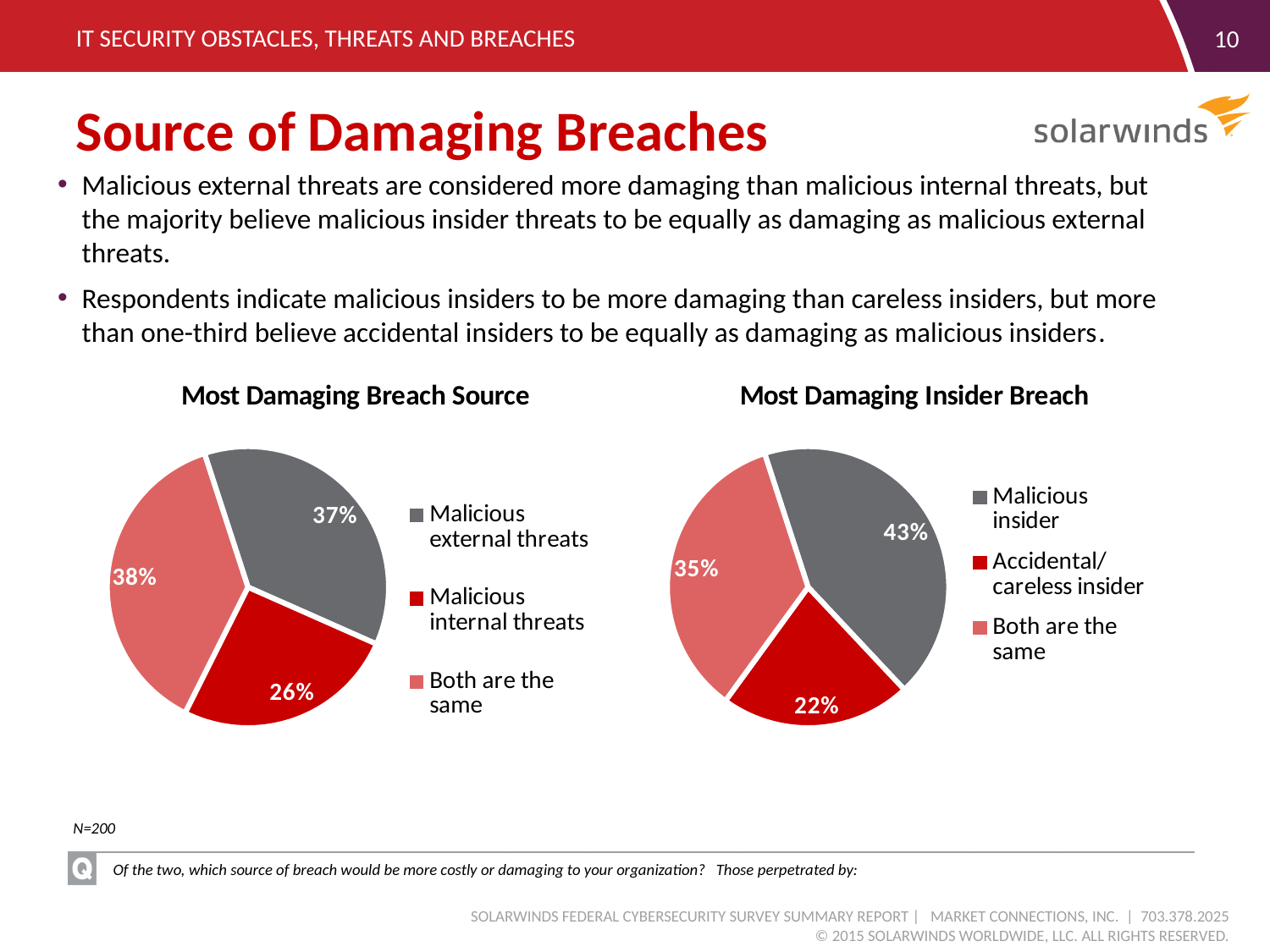
In the 'Most Damaging Insider Breach' chart, what percentage is shown for Malicious insider? 43% In the 'Most Damaging Insider Breach' chart, which category has the smallest share? Accidental/careless insider In the 'Most Damaging Breach Source' chart, what percentage is shown for Malicious internal threats? 26% In the 'Most Damaging Insider Breach' chart, what percentage is shown for Accidental/careless insider? 22% In the 'Most Damaging Breach Source' chart, which category has the smallest share? Malicious internal threats What type of chart is used for 'Most Damaging Insider Breach'? Pie chart In the 'Most Damaging Breach Source' chart, what percentage is shown for Malicious external threats? 37% In the 'Most Damaging Breach Source' chart, what percentage is shown for 'Both are the same'? 38% In the 'Most Damaging Breach Source' chart, what is the difference between the shares for Malicious external threats and Malicious internal threats? 11% In the 'Most Damaging Insider Breach' chart, which is larger: the share for Malicious insider or the share for 'Both are the same'? Malicious insider How many categories does the legend of the 'Most Damaging Breach Source' chart list? 3 In the 'Most Damaging Insider Breach' chart, which category has the largest share? Malicious insider